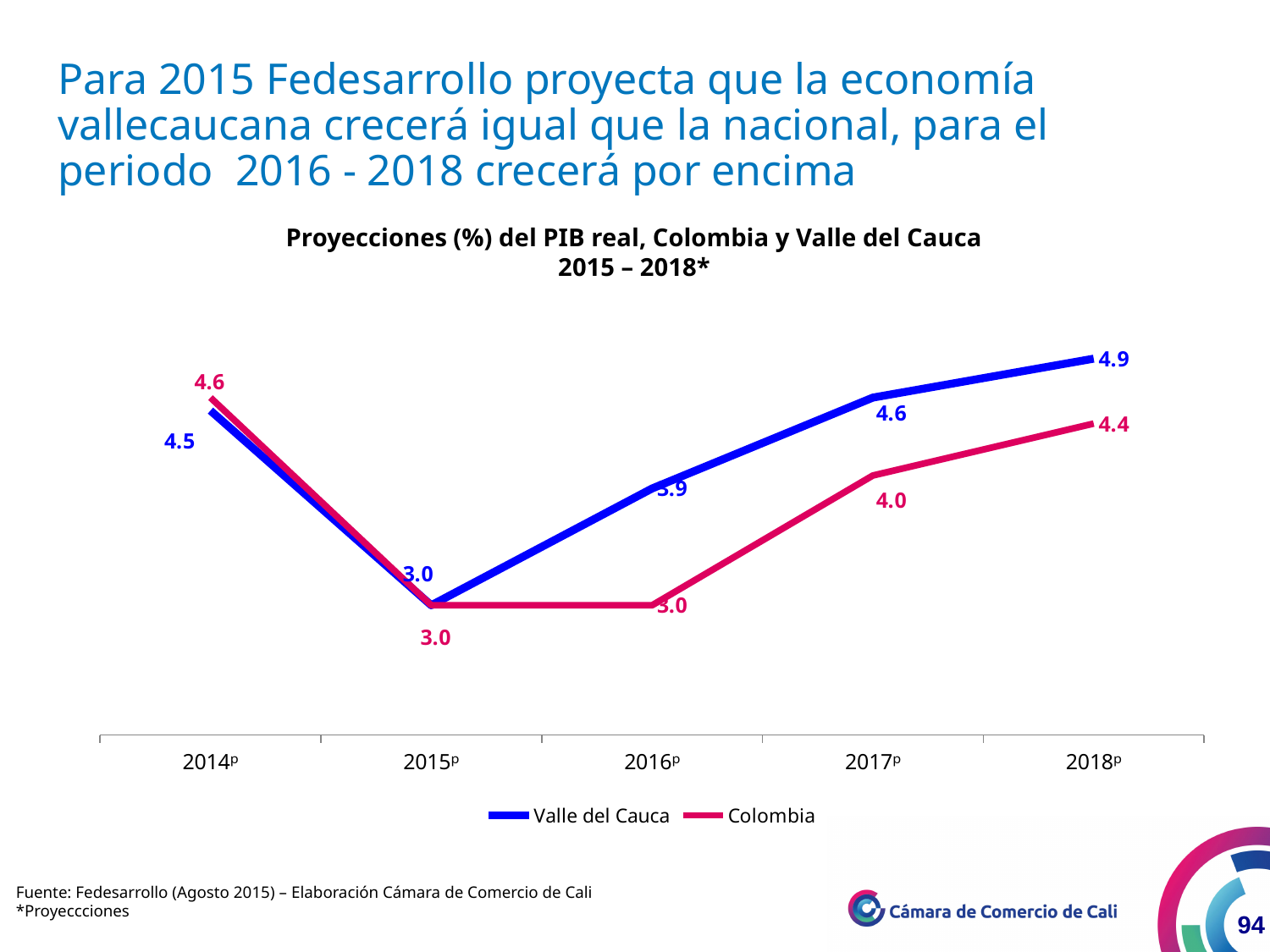
What is the difference between Valle del Cauca and Colombia in 2018? 0.5 Which colour represents the Colombia series? Pink How many years are shown on the x axis? 5 How many series does the legend list? 2 What type of chart is shown on the slide? Line chart Which series has the higher value in 2016, Valle del Cauca or Colombia? Valle del Cauca In which year is the Colombia series at its highest? 2014 What is the value for Colombia in 2014? 4.6 What is the projected value for Colombia in 2017? 4.0 What is the projected value for Valle del Cauca in 2018? 4.9 Does the Valle del Cauca series rise or fall from 2015 to 2018? Rise In which year is the Valle del Cauca series at its lowest? 2015